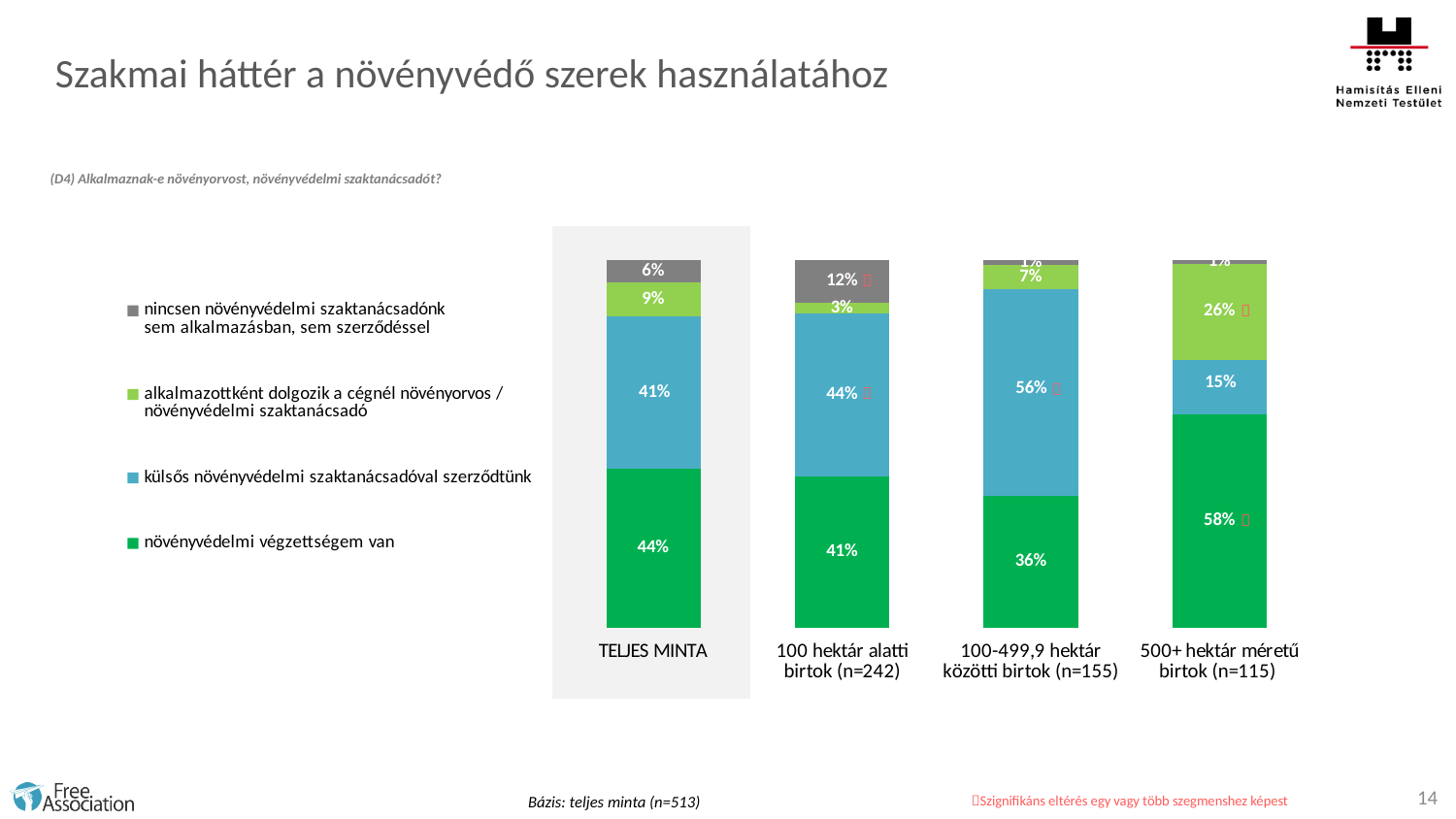
How many series does the legend list? 4 Which category has the highest value for 'növényvédelmi végzettségem van'? 500+ hektár méretű birtok (n=115) What is the value for 'alkalmazottként dolgozik a cégnél növényorvos / növényvédelmi szaktanácsadó' for the '500+ hektár méretű birtok (n=115)' category? 26% Which is larger in the TELJES MINTA bar: 'növényvédelmi végzettségem van' or 'külsős növényvédelmi szaktanácsadóval szerződtünk'? növényvédelmi végzettségem van What is the value for 'nincsen növényvédelmi szaktanácsadónk sem alkalmazásban, sem szerződéssel' for the '100 hektár alatti birtok (n=242)' category? 12% What kind of chart is shown on the slide? stacked bar chart What is the difference between the 'növényvédelmi végzettségem van' values for '500+ hektár méretű birtok (n=115)' and '100-499,9 hektár közötti birtok (n=155)'? 22% Which series is shown in dark green at the bottom of each bar? növényvédelmi végzettségem van Which category has the lowest value for 'külsős növényvédelmi szaktanácsadóval szerződtünk'? 500+ hektár méretű birtok (n=115) What is the value for 'növényvédelmi végzettségem van' in the TELJES MINTA bar? 44% What is the value for 'külsős növényvédelmi szaktanácsadóval szerződtünk' for the '100-499,9 hektár közötti birtok (n=155)' category? 56% How many categories (bars) are shown on the x axis? 4